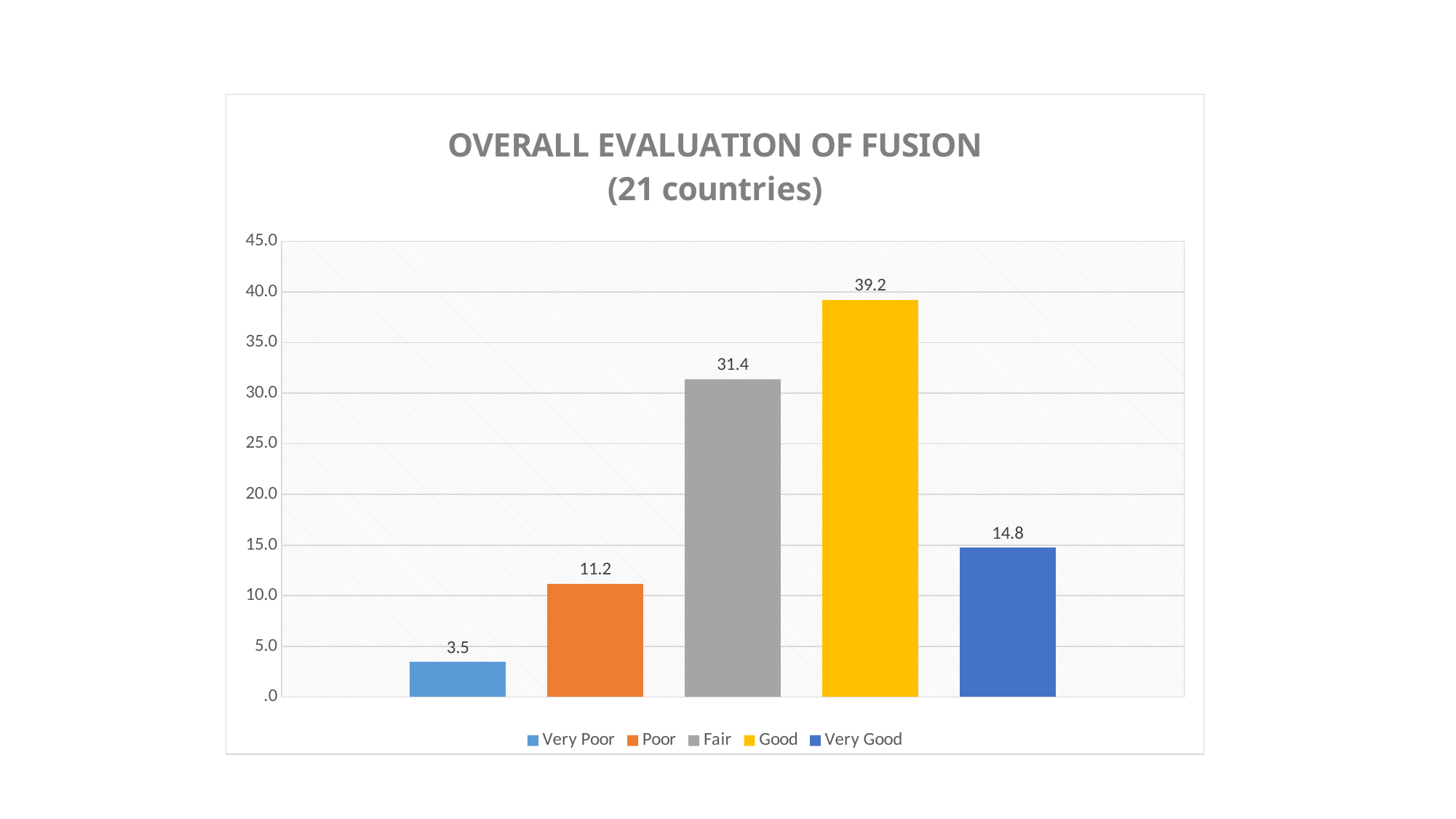
Which category has the lowest value? Very Poor What is the value for Fair? 31.4 What is the value for Very Poor? 3.5 What is the value for Good? 39.2 What is the title of the chart? OVERALL EVALUATION OF FUSION (21 countries) How many categories are shown in the chart? 5 Which category has the highest value? Good What is the difference between the values for Very Good and Poor? 3.6 Which is larger, the value for Poor or the value for Very Good? Very Good What is the value for Very Good? 14.8 What is the difference between the values for Good and Fair? 7.8 What kind of chart is shown on the slide? Bar chart